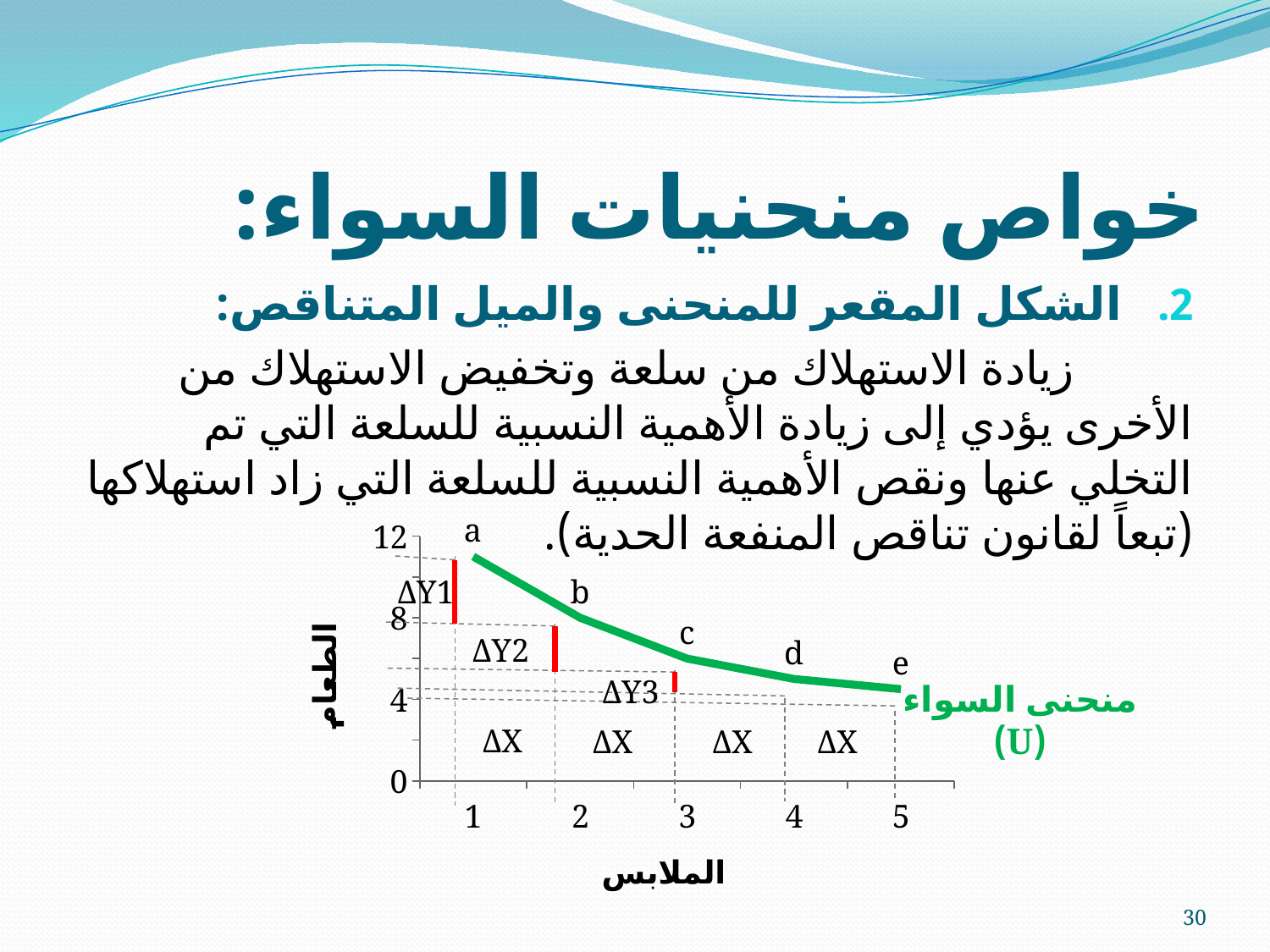
What colour is the curve labelled منحنى السواء (U)? green What is the label of the x axis of the chart? الملابس Which point has the larger y-axis value, a or e? a How many labelled points (a to e) are plotted on the curve? 5 Does the curve rise or fall as the value on the x axis (الملابس) increases? fall Is the y-axis value at point c greater or less than 8? less Which point has the larger y-axis value, b or d? b What kind of chart is shown on the slide? line chart Which labelled point on the curve has the highest value on the y axis? a Is the y-axis value at point a greater or less than 12? less Is the y-axis value at point c greater or less than 4? greater